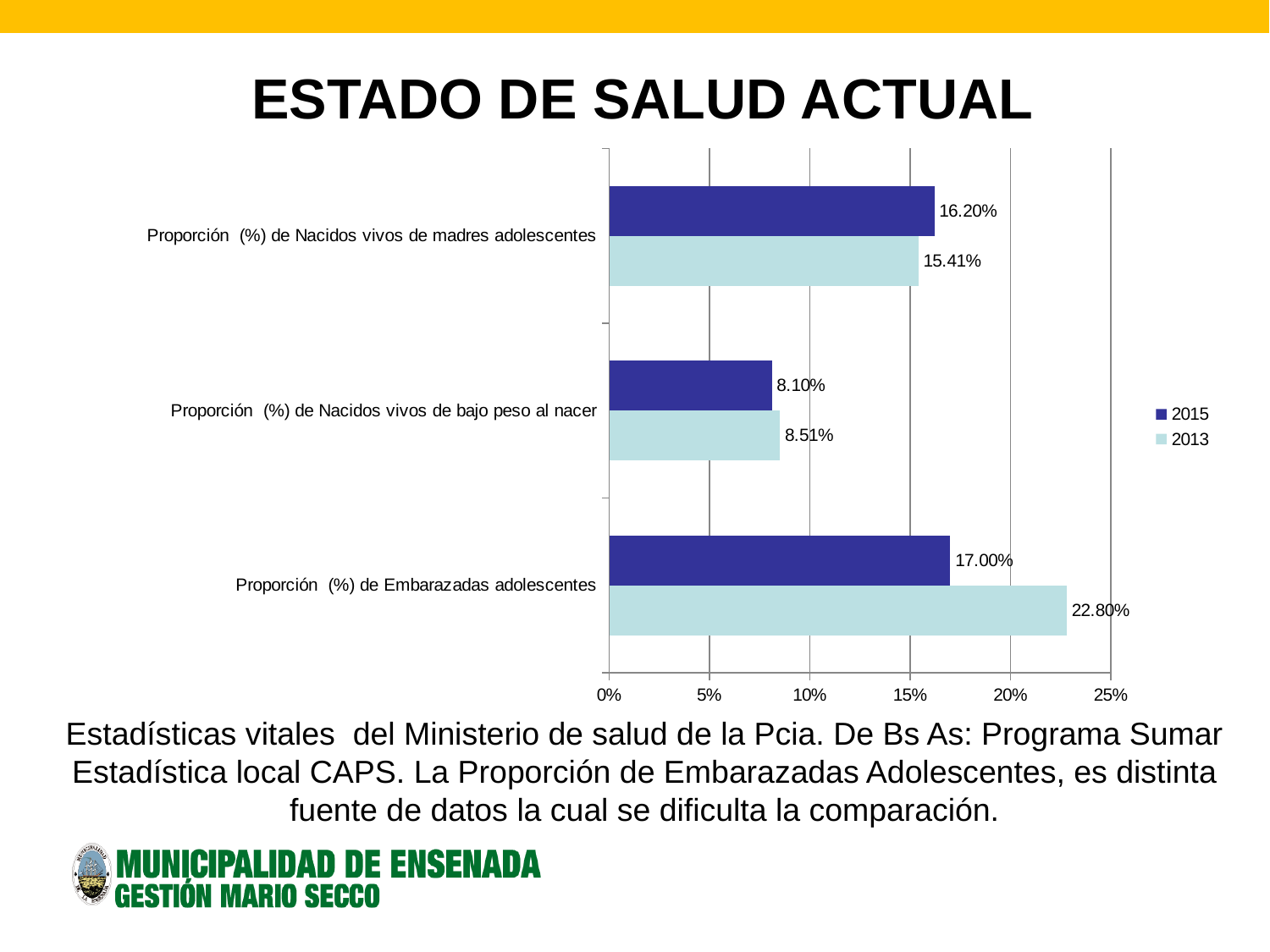
What is the 2015 value for Proporción (%) de Nacidos vivos de madres adolescentes? 16.20% For Proporción (%) de Nacidos vivos de madres adolescentes, which year has the larger value, 2015 or 2013? 2015 What is the 2015 value for Proporción (%) de Embarazadas adolescentes? 17.00% What is the difference between the 2013 and 2015 values for Proporción (%) de Embarazadas adolescentes? 5.80% Is the 2013 value for Proporción (%) de Embarazadas adolescentes greater or less than 20%? greater What kind of chart is shown on the slide? Bar chart What is the 2013 value for Proporción (%) de Nacidos vivos de bajo peso al nacer? 8.51% How many series does the legend list? 2 What is the 2013 value for Proporción (%) de Embarazadas adolescentes? 22.80% Which category has the lowest 2015 value? Proporción (%) de Nacidos vivos de bajo peso al nacer Which category has the highest 2013 value? Proporción (%) de Embarazadas adolescentes How many categories are shown on the chart? 3